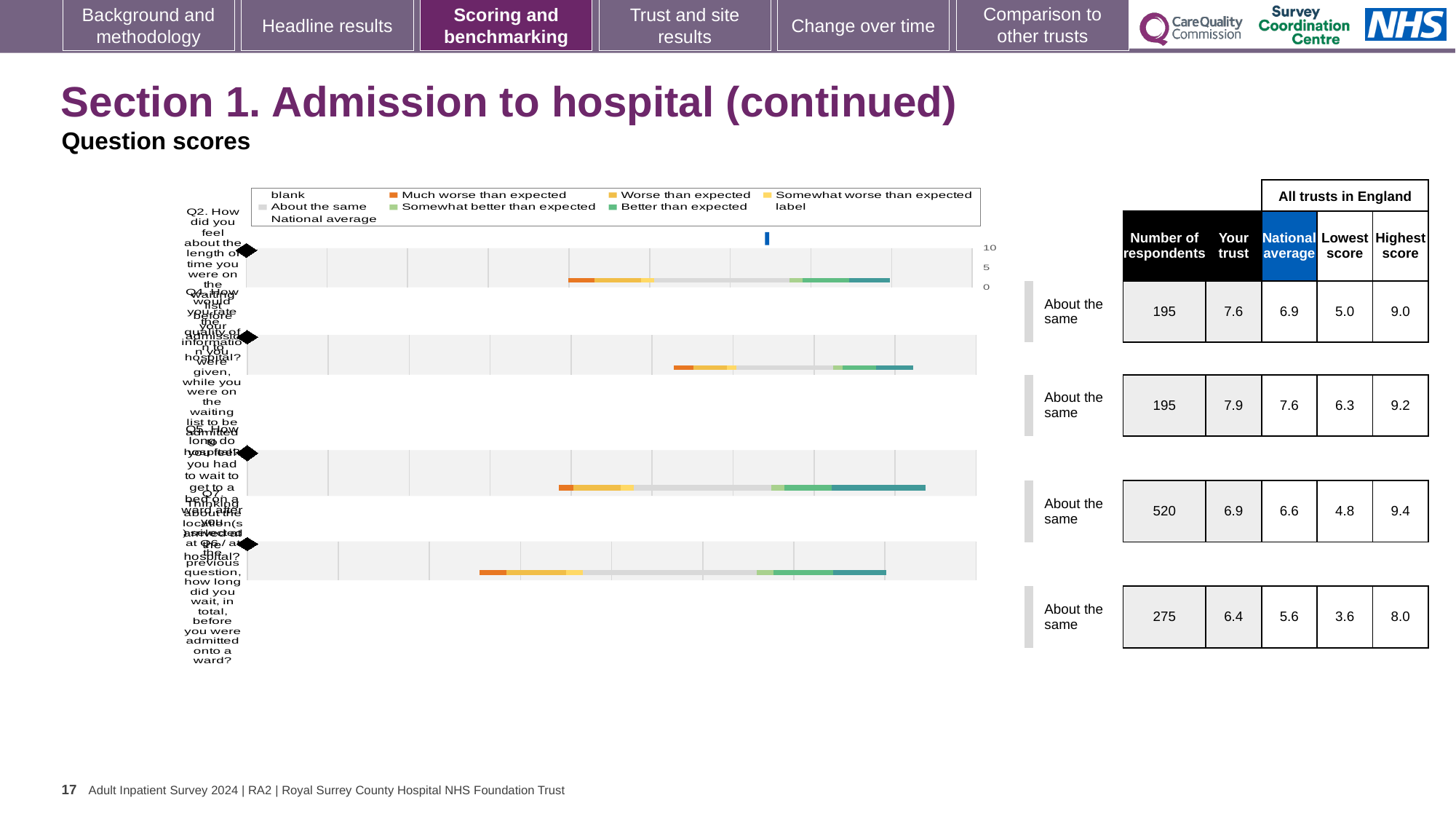
What is the national average in the second row of the table? 7.6 What is the 'Your trust' score in the top row of the table? 7.6 Which row of the table has the lowest 'Lowest score' value? fourth row (3.6) What kind of chart is shown on the slide? bar chart How many entries does the chart legend list? 9 How many horizontal bars (questions) are plotted in the chart? 4 What is the maximum value shown on the chart's score axis? 10 In the fourth row of the table, what is the difference between the 'Your trust' score and the national average? 0.8 Which row of the table has the highest number of respondents? third row (520) What is the number of respondents in the third row of the table? 520 Which colour does the legend use for 'Much worse than expected'? orange In the top row of the table, which is larger: the 'Your trust' score or the national average? Your trust